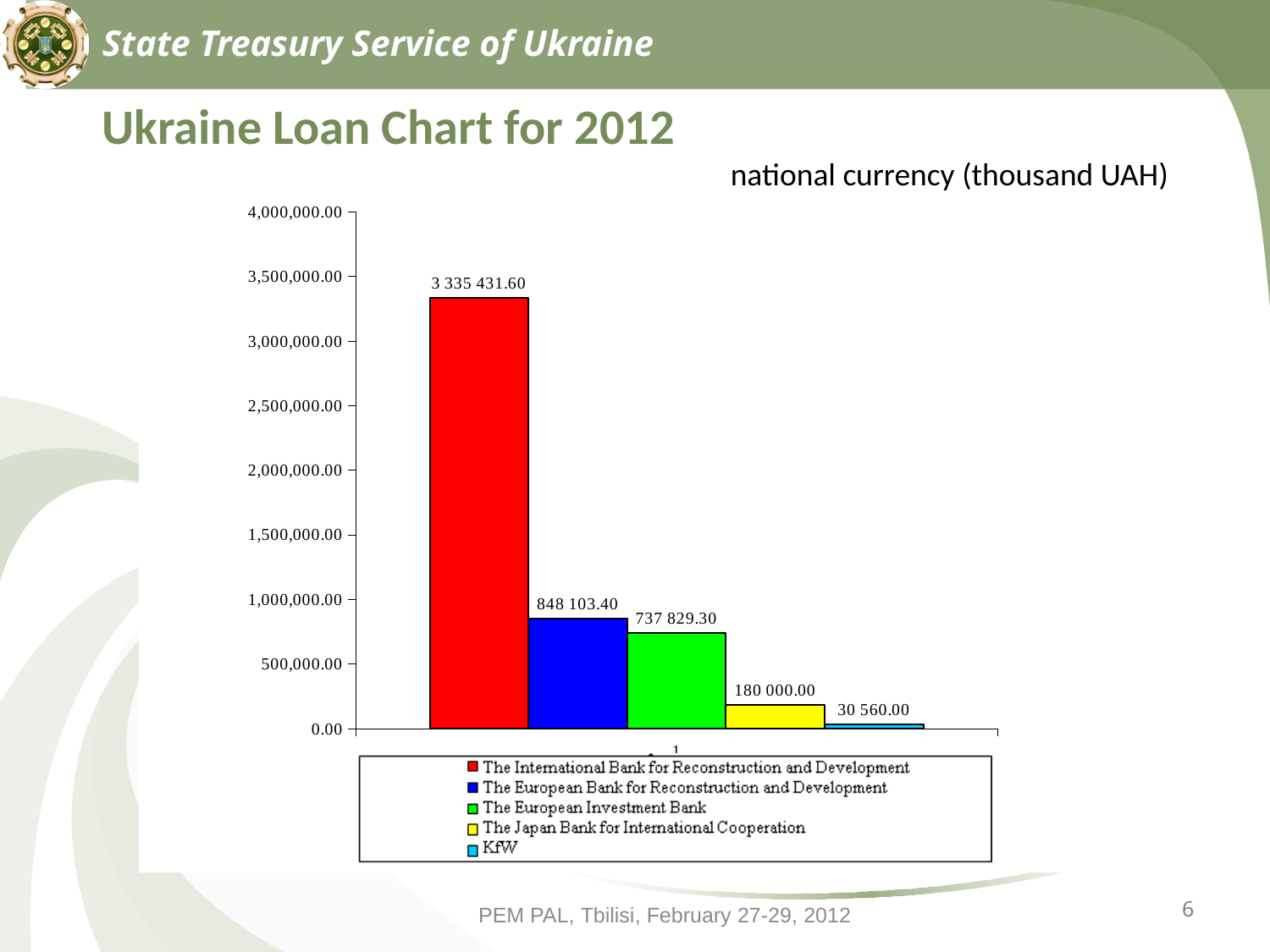
Which lender has the lowest loan value? KfW What is the loan value for KfW? 30 560.00 What is the loan value for The European Bank for Reconstruction and Development? 848 103.40 How many series does the legend list? 5 What is the loan value for The European Investment Bank? 737 829.30 Which lender has the highest loan value? The International Bank for Reconstruction and Development What is the loan value for The Japan Bank for International Cooperation? 180 000.00 What is the difference between the loan values of The European Bank for Reconstruction and Development and The European Investment Bank? 110 274.10 Which is larger, the loan value for The European Investment Bank or for The Japan Bank for International Cooperation? The European Investment Bank What is the difference between the loan values of The Japan Bank for International Cooperation and KfW? 149 440.00 What kind of chart is shown on the slide? Bar chart What is the loan value for The International Bank for Reconstruction and Development? 3 335 431.60